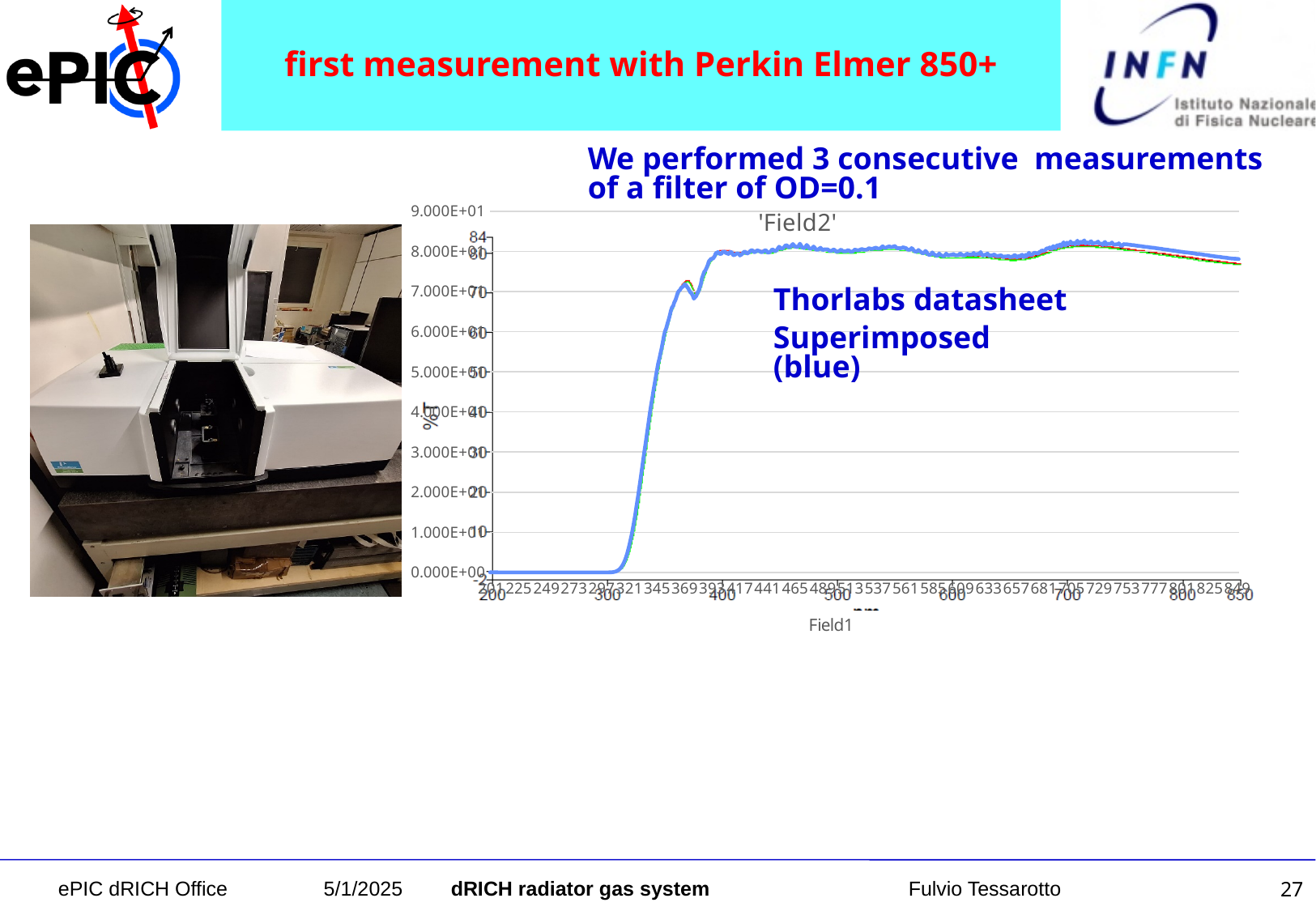
What is the highest tick value shown on the left y axis? 9.000E+01 What kind of chart is shown on the slide? line chart Is the value at x = 441 greater or less than 7.000E+01? greater Do the values rise or fall between x = 321 and x = 393? rise Is the value at x = 201 greater or less than 1.000E+01? less Which has the larger value, x = 249 or x = 465? 465 Is the value at x = 609 greater or less than 6.000E+01? greater Which has the larger value, x = 705 or x = 273? 705 What is the title of the chart on the slide? 'Field2' What is the label of the x axis of the chart? Field1